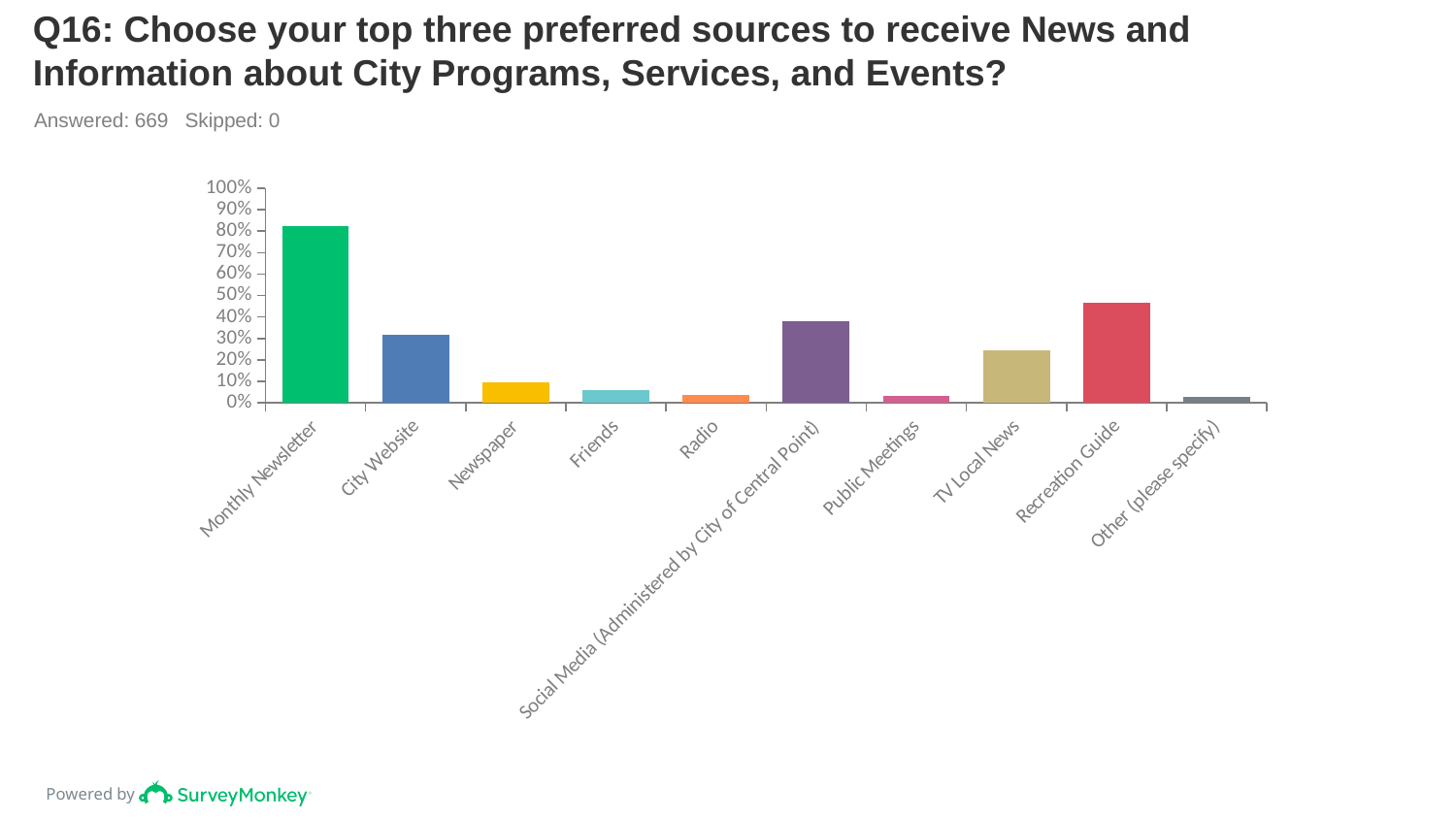
Is the value for Newspaper greater or less than 20%? less Which has a larger value, City Website or TV Local News? City Website What kind of chart is shown on the slide? bar chart What is the highest percentage shown on the y axis of the chart? 100% Is the value for Recreation Guide greater or less than 40%? greater Which has a larger value, Recreation Guide or Social Media (Administered by City of Central Point)? Recreation Guide Is the value for Monthly Newsletter greater or less than 70%? greater How many respondents answered this question according to the slide? 669 How many categories (sources) are shown on the x axis of the chart? 10 Which source has the highest value in the chart? Monthly Newsletter